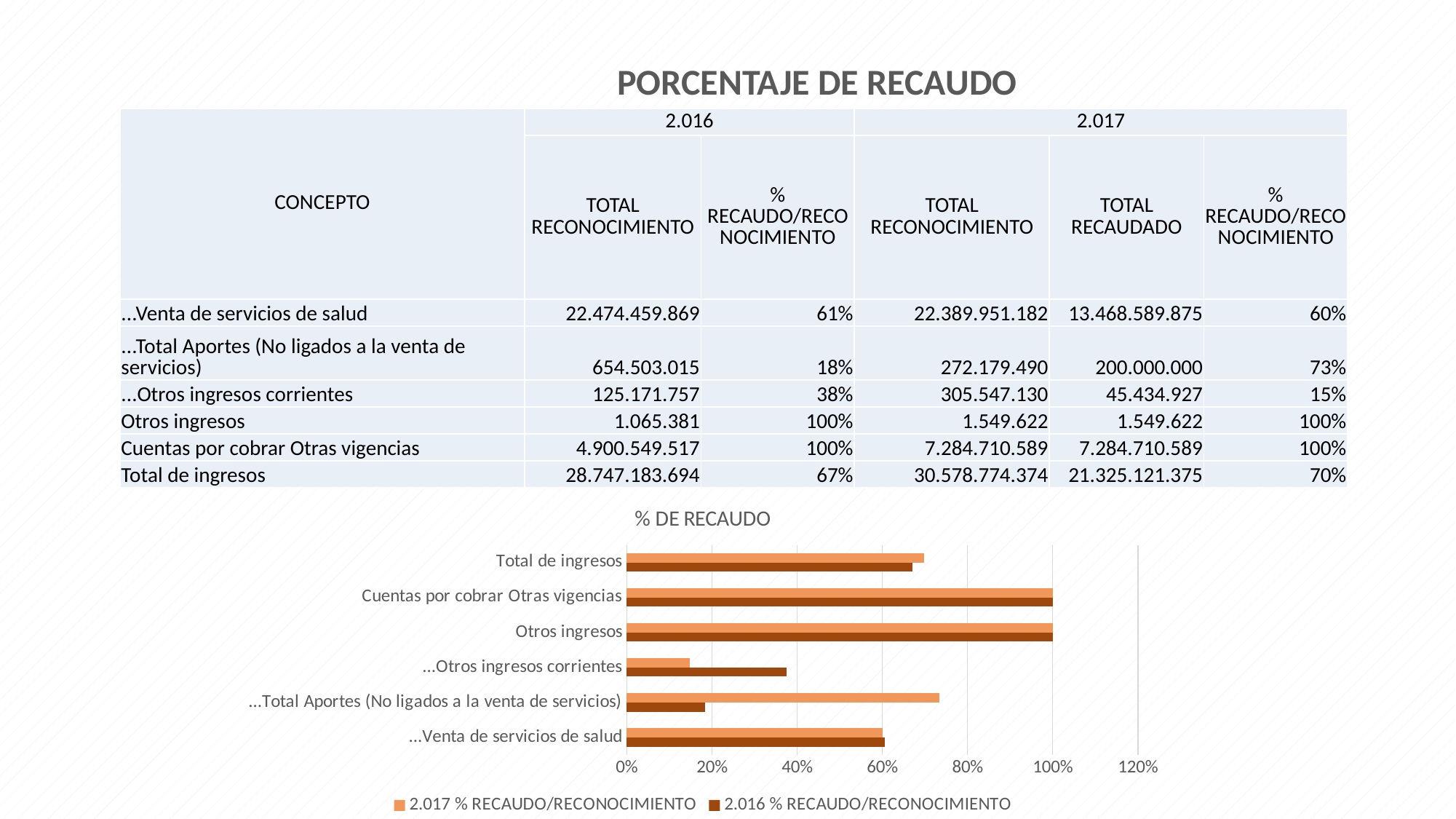
What is the title of the bar chart on the slide? % DE RECAUDO In the % DE RECAUDO chart, what is the 2.017 % RECAUDO/RECONOCIMIENTO value for Cuentas por cobrar Otras vigencias? 100% How many series does the legend of the % DE RECAUDO chart list? 2 How many categories are plotted in the % DE RECAUDO chart? 6 In the % DE RECAUDO chart, which series has the larger value for ...Otros ingresos corrientes, 2.017 or 2.016? 2.016 According to the table, what is the 2.017 % RECAUDO/RECONOCIMIENTO for Total de ingresos? 70% What kind of chart is shown below the table on the slide? bar chart In the % DE RECAUDO chart, which category has the lowest 2.017 % RECAUDO/RECONOCIMIENTO value? ...Otros ingresos corrientes In the % DE RECAUDO chart, is the 2.017 value for ...Total Aportes (No ligados a la venta de servicios) greater or less than 60%? greater In the % DE RECAUDO chart, which series has the larger value for ...Total Aportes (No ligados a la venta de servicios), 2.017 or 2.016? 2.017 In the % DE RECAUDO chart, is the 2.016 value for ...Otros ingresos corrientes greater or less than 20%? greater In the % DE RECAUDO chart, what is the 2.016 % RECAUDO/RECONOCIMIENTO value for Otros ingresos? 100%